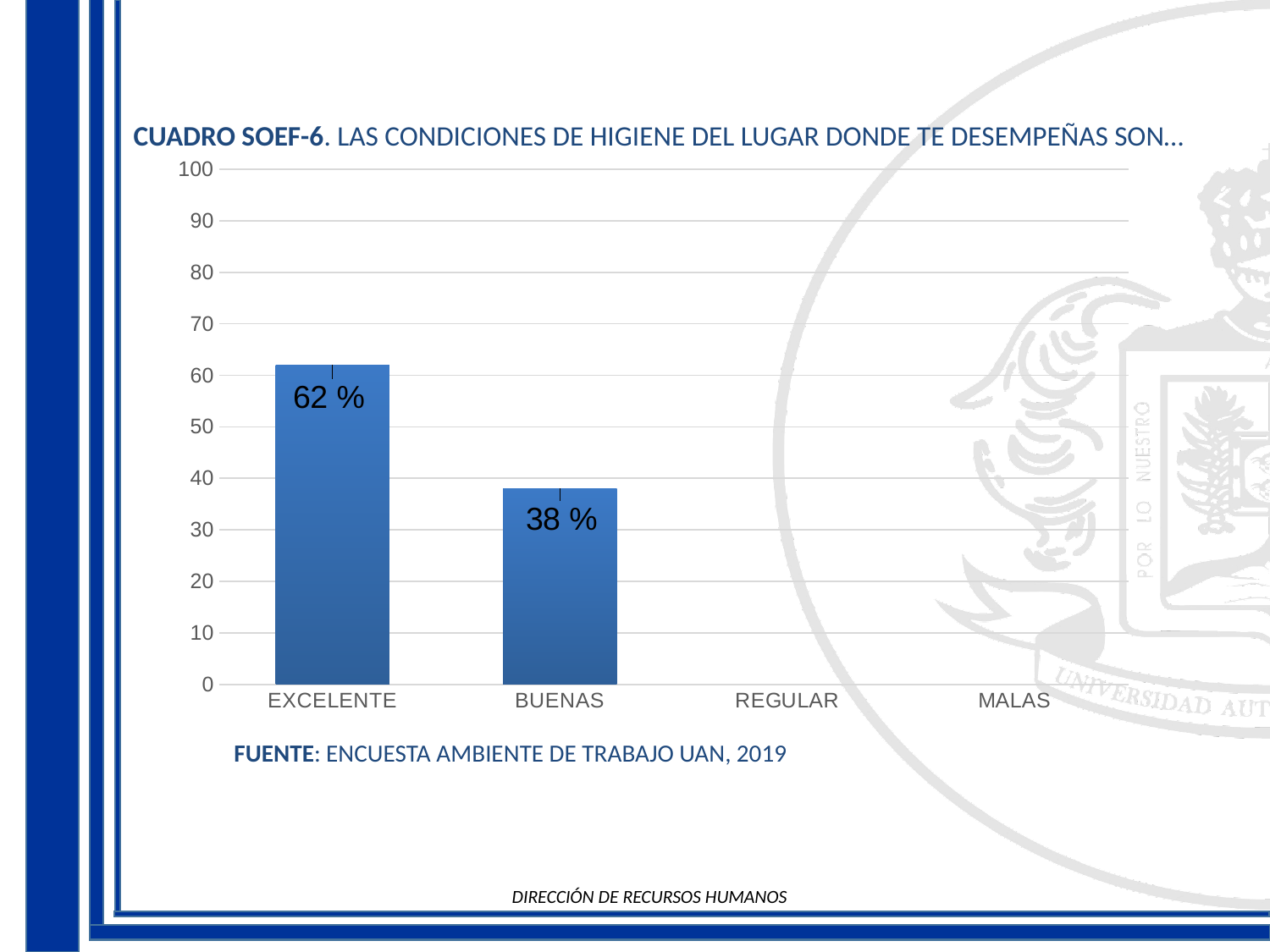
Is the value for BUENAS greater or less than 40? less What is the maximum value shown on the y axis? 100 What is the value for BUENAS? 38 % Is the value for EXCELENTE greater or less than 50? greater Which is larger, the value for EXCELENTE or the value for BUENAS? EXCELENTE What source is cited below the chart? ENCUESTA AMBIENTE DE TRABAJO UAN, 2019 Which category has the highest value? EXCELENTE Do the values rise or fall from EXCELENTE to BUENAS? fall What kind of chart is shown on the slide? bar chart How many categories are shown on the x axis? 4 What is the value for EXCELENTE? 62 % What is the difference between the values for EXCELENTE and BUENAS? 24 %